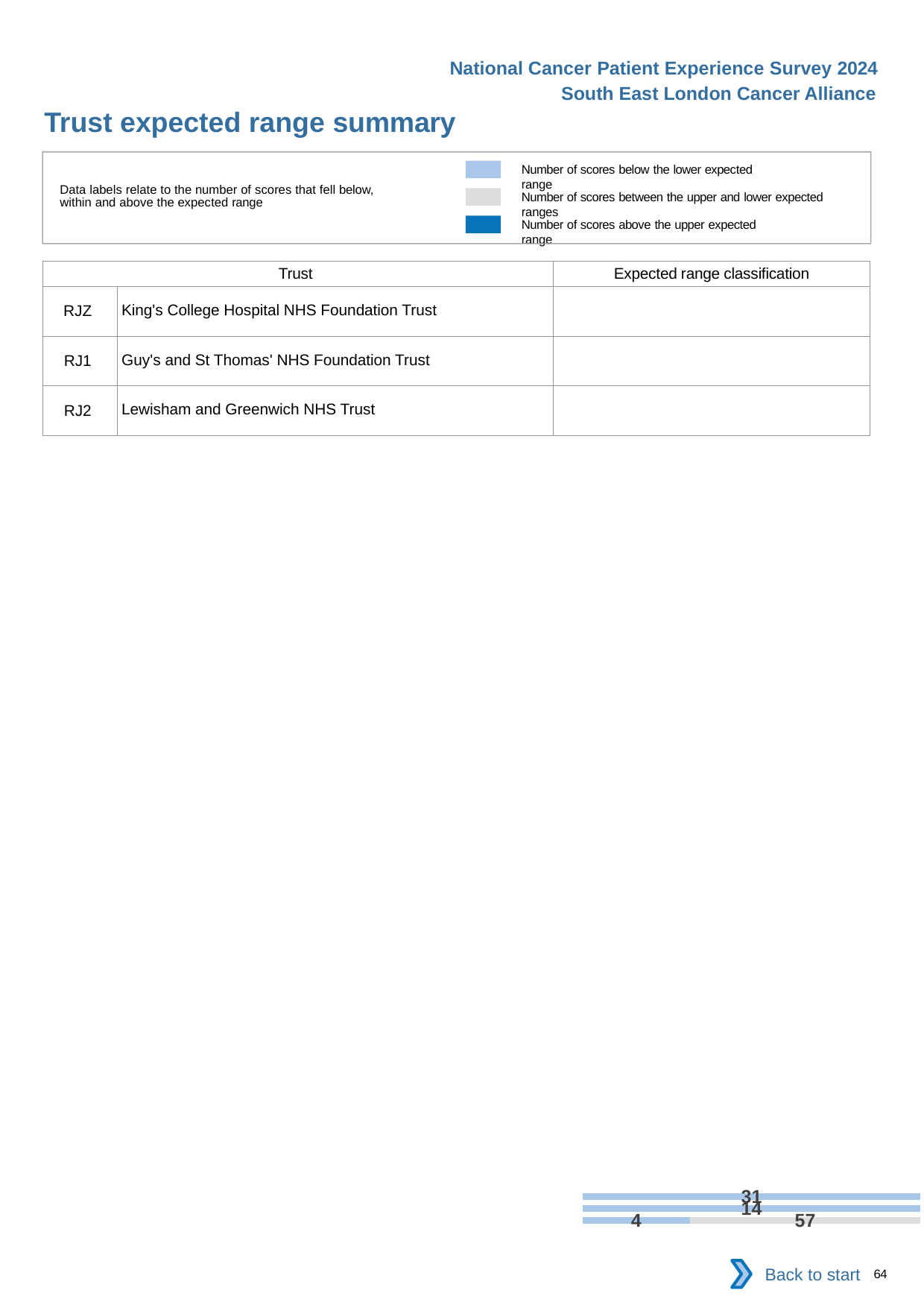
Which is larger among the printed data labels, 31 or 14? 31 How many series does the legend list? 3 What is the largest data label printed on the bars? 57 What does the light blue colour in the legend represent? Number of scores below the lower expected range What is the difference between the printed data labels 57 and 4? 53 What kind of chart is shown at the bottom of the slide? bar chart What does the dark blue colour in the legend represent? Number of scores above the upper expected range What is the smallest data label printed on the bars? 4